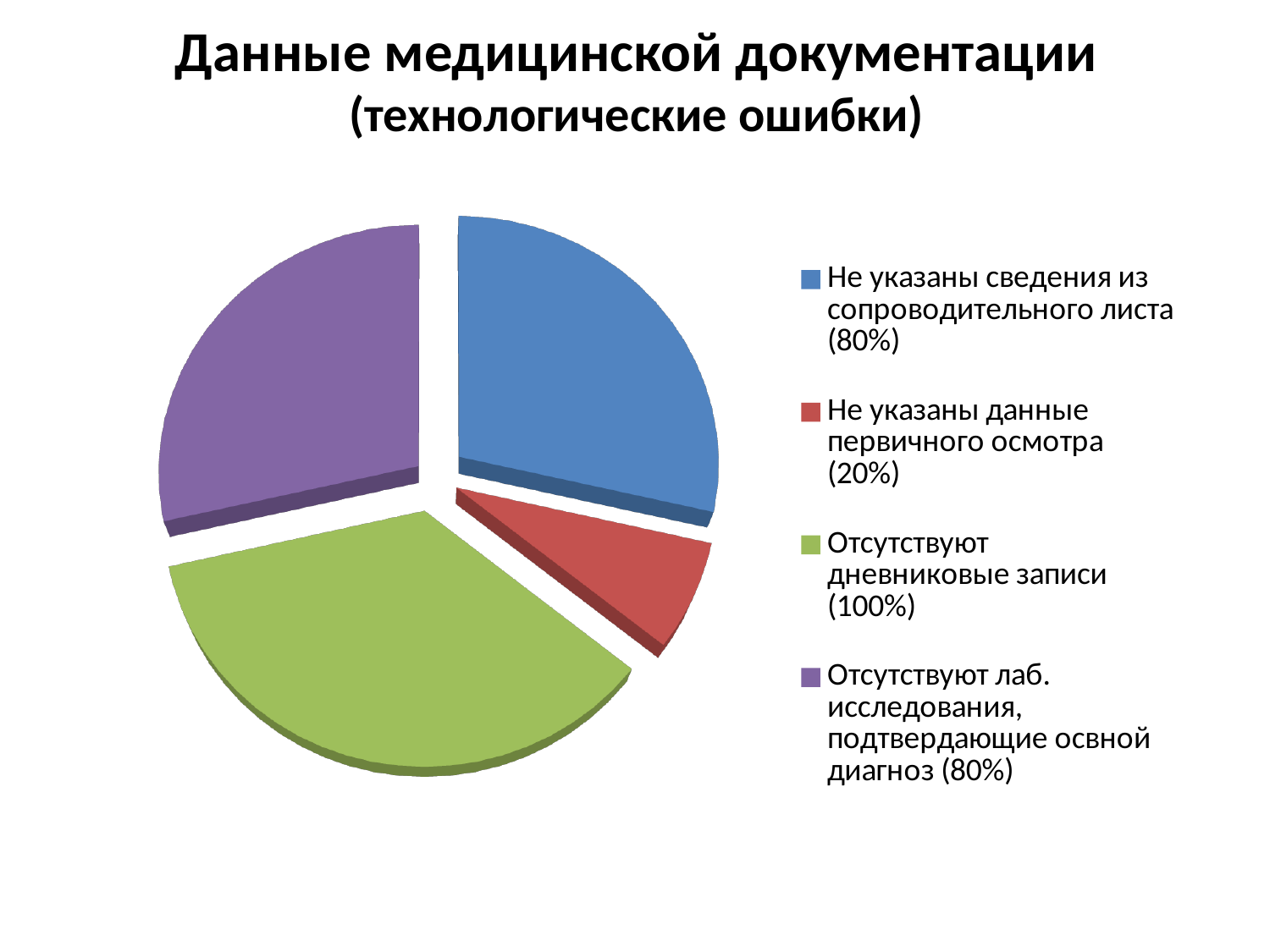
What percentage is given in the legend for "Отсутствуют дневниковые записи"? 100% Which category has the smallest slice of the pie? Не указаны данные первичного осмотра (20%) What percentage is given in the legend for "Не указаны сведения из сопроводительного листа"? 80% What is the title of the chart on the slide? Данные медицинской документации (технологические ошибки) What is the difference between the percentages given for "Отсутствуют дневниковые записи" and "Не указаны данные первичного осмотра"? 80% What kind of chart is shown on the slide? Pie chart Which category has the largest slice of the pie? Отсутствуют дневниковые записи (100%) What percentage is given in the legend for "Не указаны данные первичного осмотра"? 20% What colour is the slice for "Отсутствуют дневниковые записи"? Green Which is larger: the slice for "Отсутствуют дневниковые записи" or the slice for "Не указаны данные первичного осмотра"? Отсутствуют дневниковые записи How many slices does the pie chart have? 4 What percentage is given in the legend for "Отсутствуют лаб. исследования, подтвердающие освной диагноз"? 80%